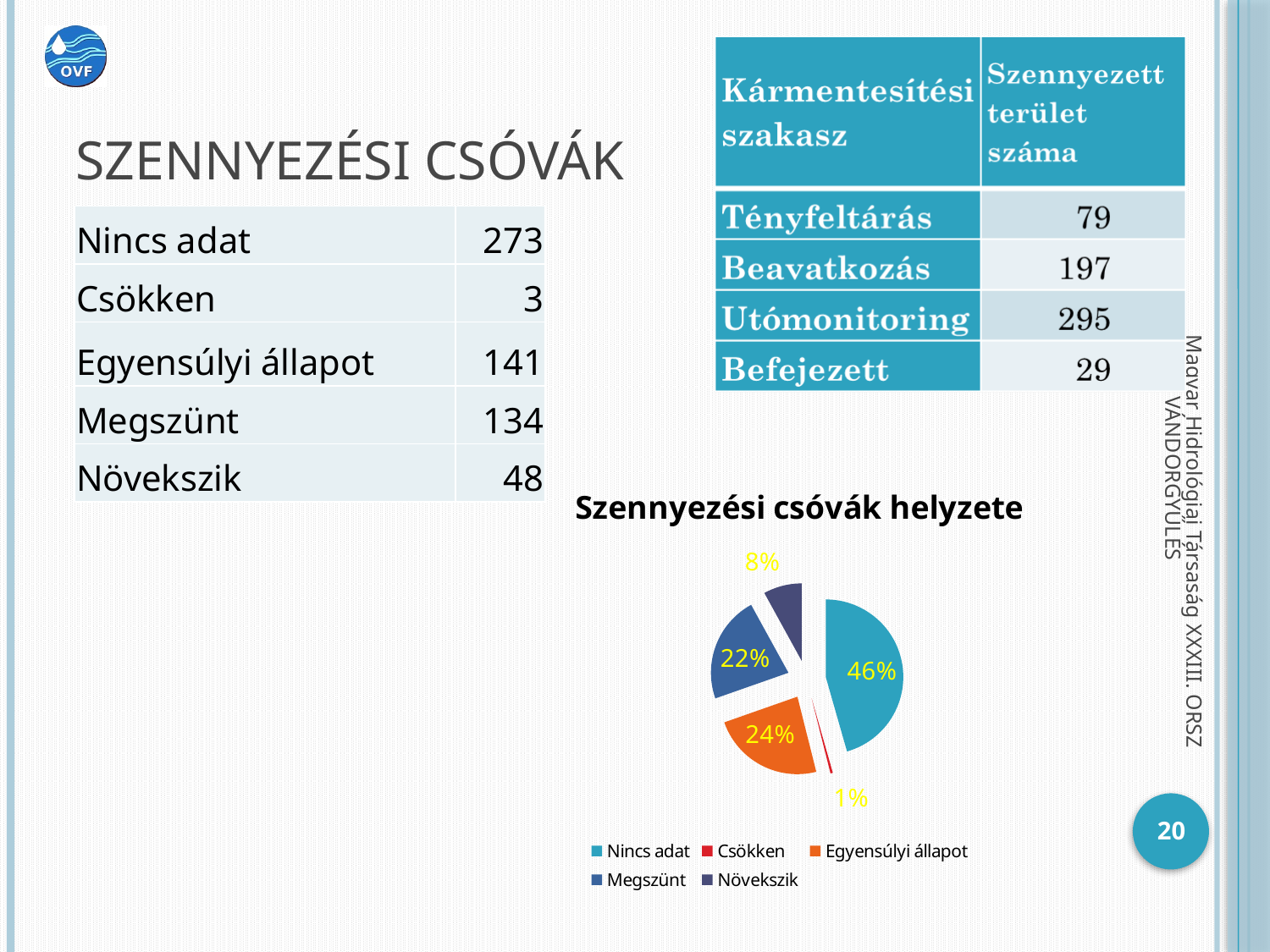
What percentage of the pie chart does the Nincs adat slice represent? 46% What percentage is shown for the Növekszik slice? 8% What kind of chart is shown on the slide? pie chart What is the title of the pie chart? Szennyezési csóvák helyzete What percentage is shown for the Csökken slice? 1% Which category has the largest slice in the pie chart? Nincs adat What is the difference in percentage points between the Nincs adat slice and the Egyensúlyi állapot slice? 22 percentage points Which slice is larger, Megszünt or Növekszik? Megszünt What percentage is shown for the Megszünt slice? 22% Which category has the smallest slice in the pie chart? Csökken How many categories does the pie chart legend list? 5 What percentage is shown for the Egyensúlyi állapot slice? 24%